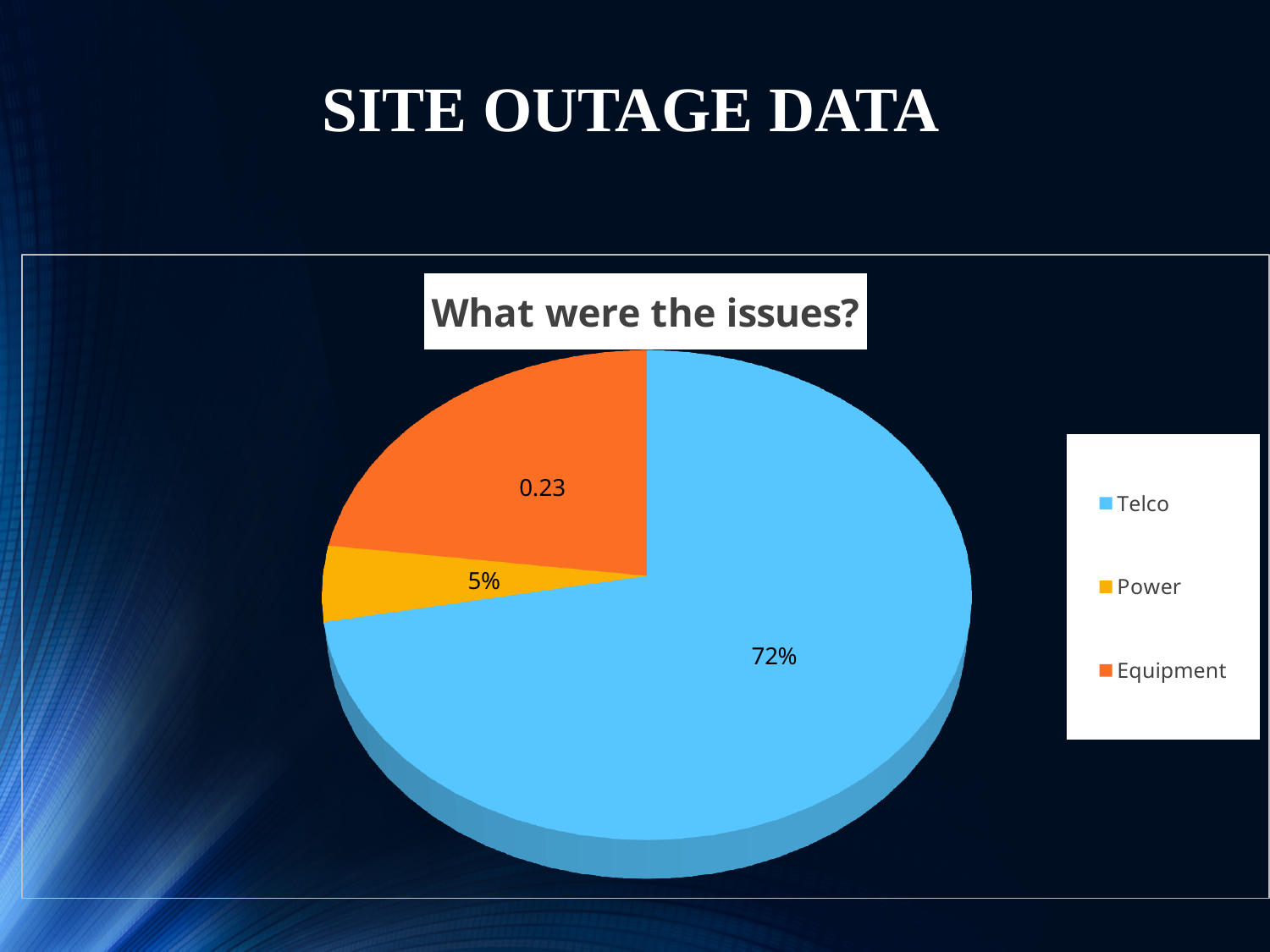
What is the value shown for the Equipment slice? 0.23 What is the title of the chart? What were the issues? Which slice is larger, Telco or Equipment? Telco What is the value shown for the Power slice? 5% What kind of chart is shown on the slide? pie chart What is the value shown for the Telco slice? 72% How many categories does the legend list? 3 Which slice is larger, Equipment or Power? Equipment What is the difference between the Telco and Power values? 67% Which category has the largest slice of the pie? Telco Which category has the smallest slice of the pie? Power What colour is the Telco slice? light blue